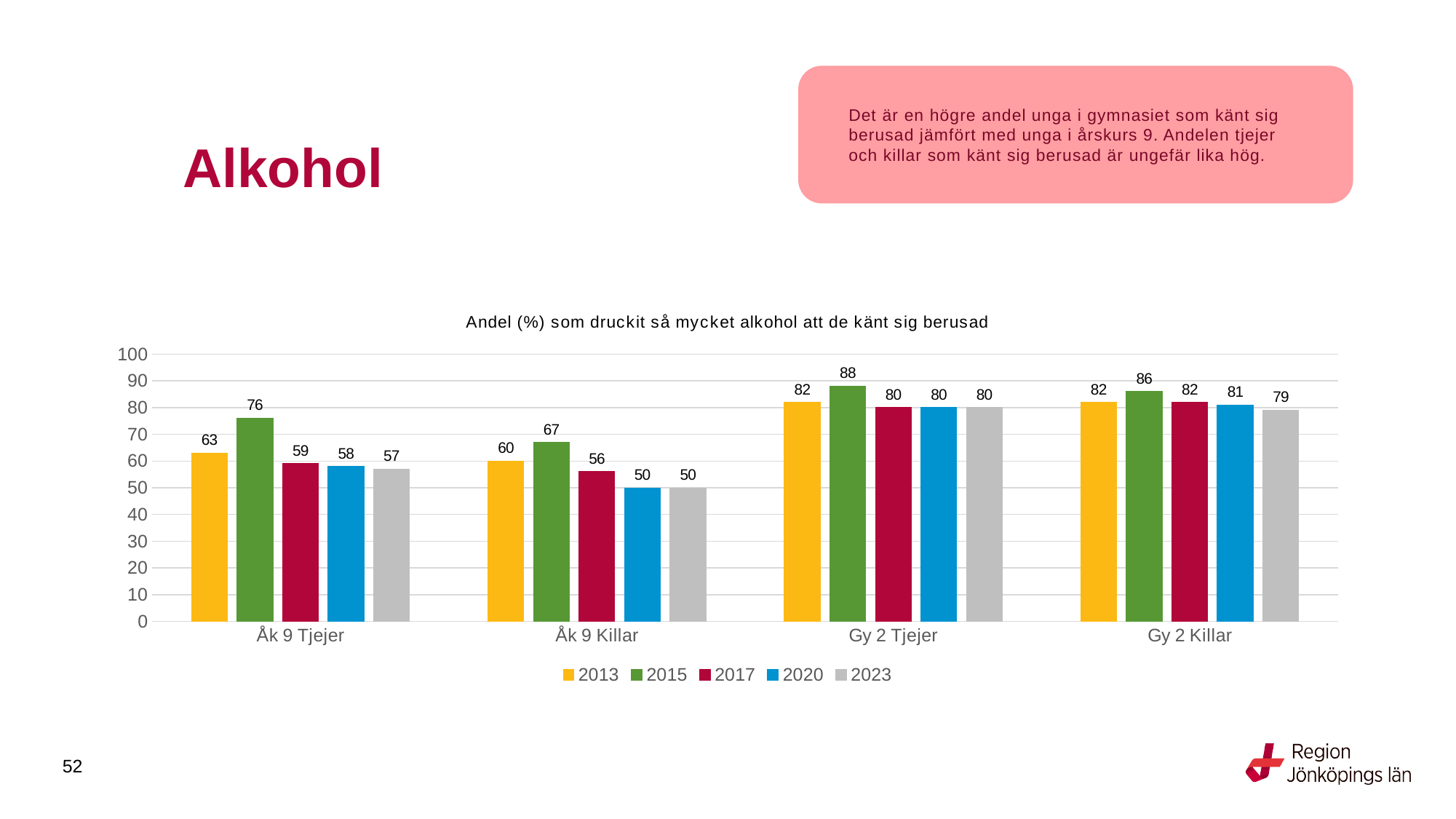
What kind of chart is shown on the slide? Bar chart What is the value for Åk 9 Killar in 2020? 50 How many categories are shown on the x axis? 4 Is the value for Gy 2 Tjejer in 2015 greater or less than 80? greater Which category has the highest value in 2015? Gy 2 Tjejer How many series does the legend list? 5 What is the value for Gy 2 Killar in 2023? 79 What is the value for Åk 9 Tjejer in 2015? 76 What is the difference between the 2015 and 2023 values for Åk 9 Tjejer? 19 What is the title of the chart? Andel (%) som druckit så mycket alkohol att de känt sig berusad Which category has the lowest value in 2023? Åk 9 Killar Which is larger: the 2013 value for Åk 9 Tjejer or the 2013 value for Åk 9 Killar? Åk 9 Tjejer